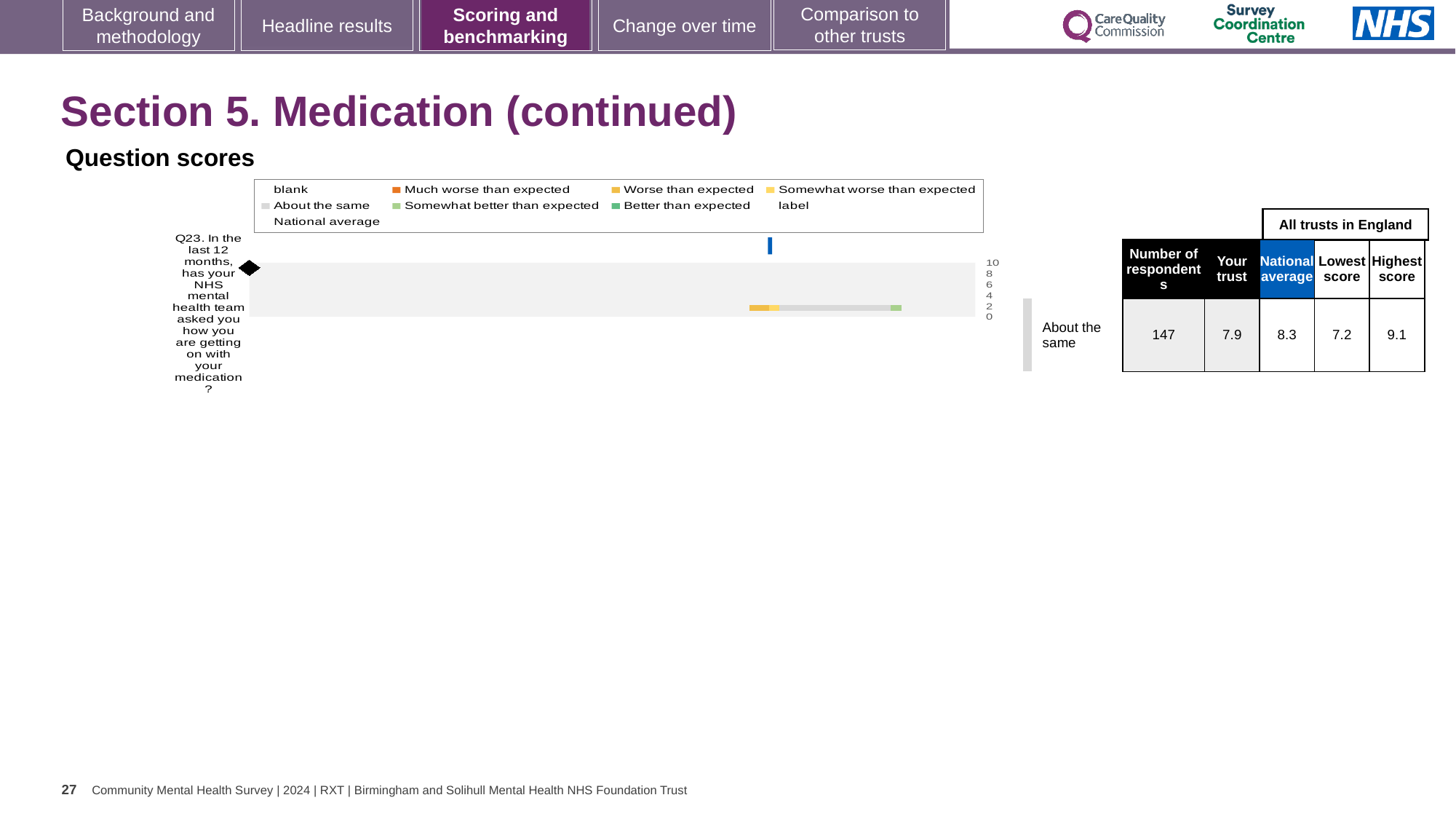
Which is larger for Q23, the 'Your trust' score or the national average? national average How many respondents answered Q23? 147 What is the highest value shown on the chart's score axis? 10 How many questions (categories) are plotted in the Question scores chart? 1 What benchmark category label is shown to the right of the Q23 bar? About the same What is the 'Your trust' score for Q23 shown next to the chart? 7.9 What is the national average score for Q23 shown next to the chart? 8.3 Which question is plotted in the Question scores chart? Q23. In the last 12 months, has your NHS mental health team asked you how you are getting on with your medication? What kind of chart is shown under 'Question scores'? bar chart What is the difference between the highest score (9.1) and the lowest score (7.2) for Q23? 1.9